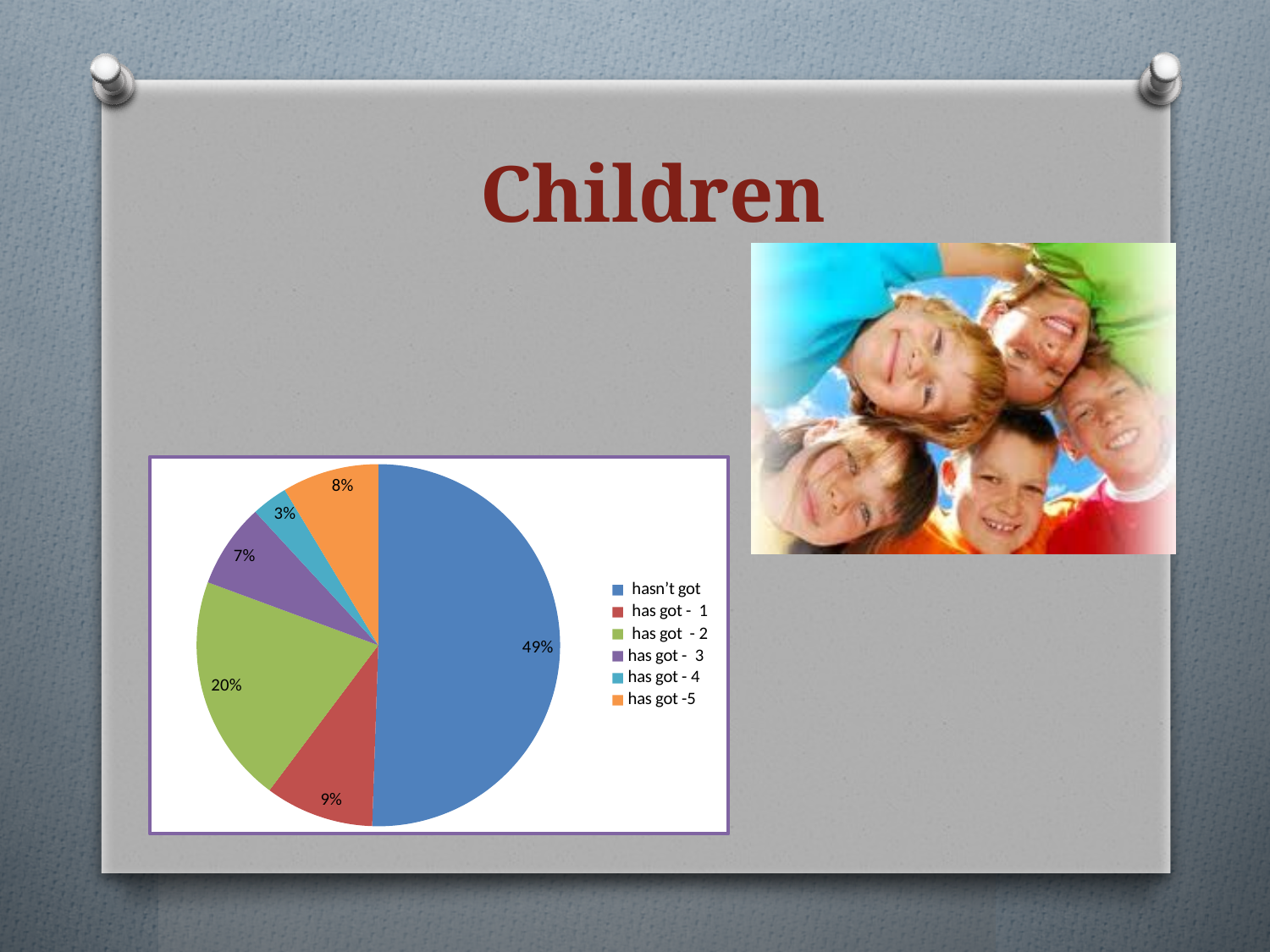
What kind of chart is shown on the slide? pie chart What share of the pie does "has got - 4" take? 3% What share of the pie does "hasn't got" take? 49% What share of the pie does "has got - 1" take? 9% Which category has the smallest slice of the pie? has got - 4 How many categories does the legend list? 6 Which category has the largest slice of the pie? hasn't got What is the title of the slide containing the pie chart? Children Which is larger, the slice for "has got - 1" or the slice for "has got -5"? has got - 1 What is the difference in percentage points between "has got - 2" and "has got - 3"? 13